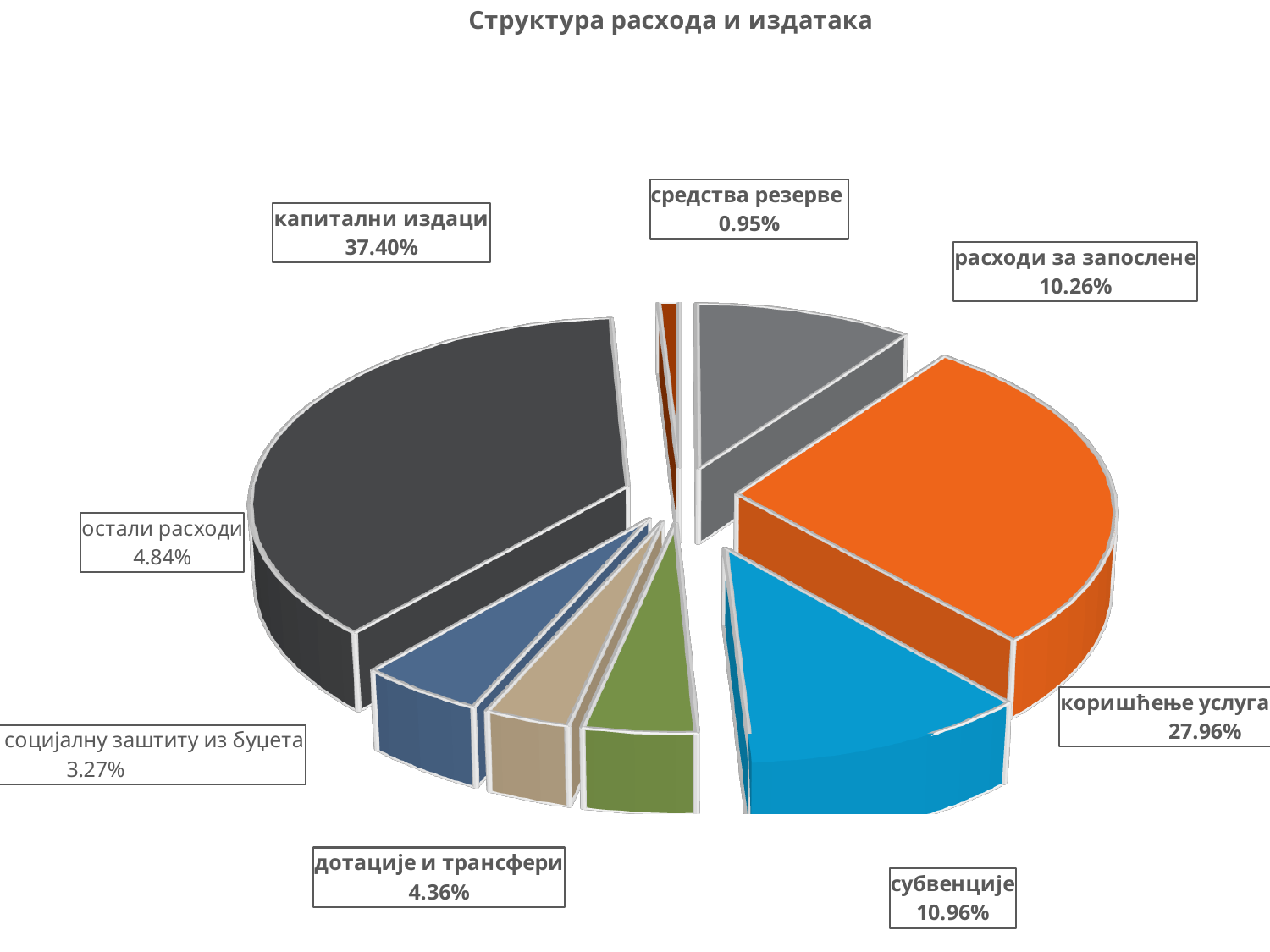
What share does капитални издаци have? 37.40% Which is larger, субвенције or расходи за запослене? субвенције Which category has the smallest share? средства резерве What is the difference between the shares of капитални издаци and коришћење услуга? 9.44% What share does социјалну заштиту из буџета have? 3.27% How many slices does the pie chart have? 8 What share does средства резерве have? 0.95% Which category has the largest share? капитални издаци What is the difference between the shares of остали расходи and дотације и трансфери? 0.48% What type of chart is shown on the slide? pie chart What share does коришћење услуга have? 27.96% What is the title of the chart? Структура расхода и издатака